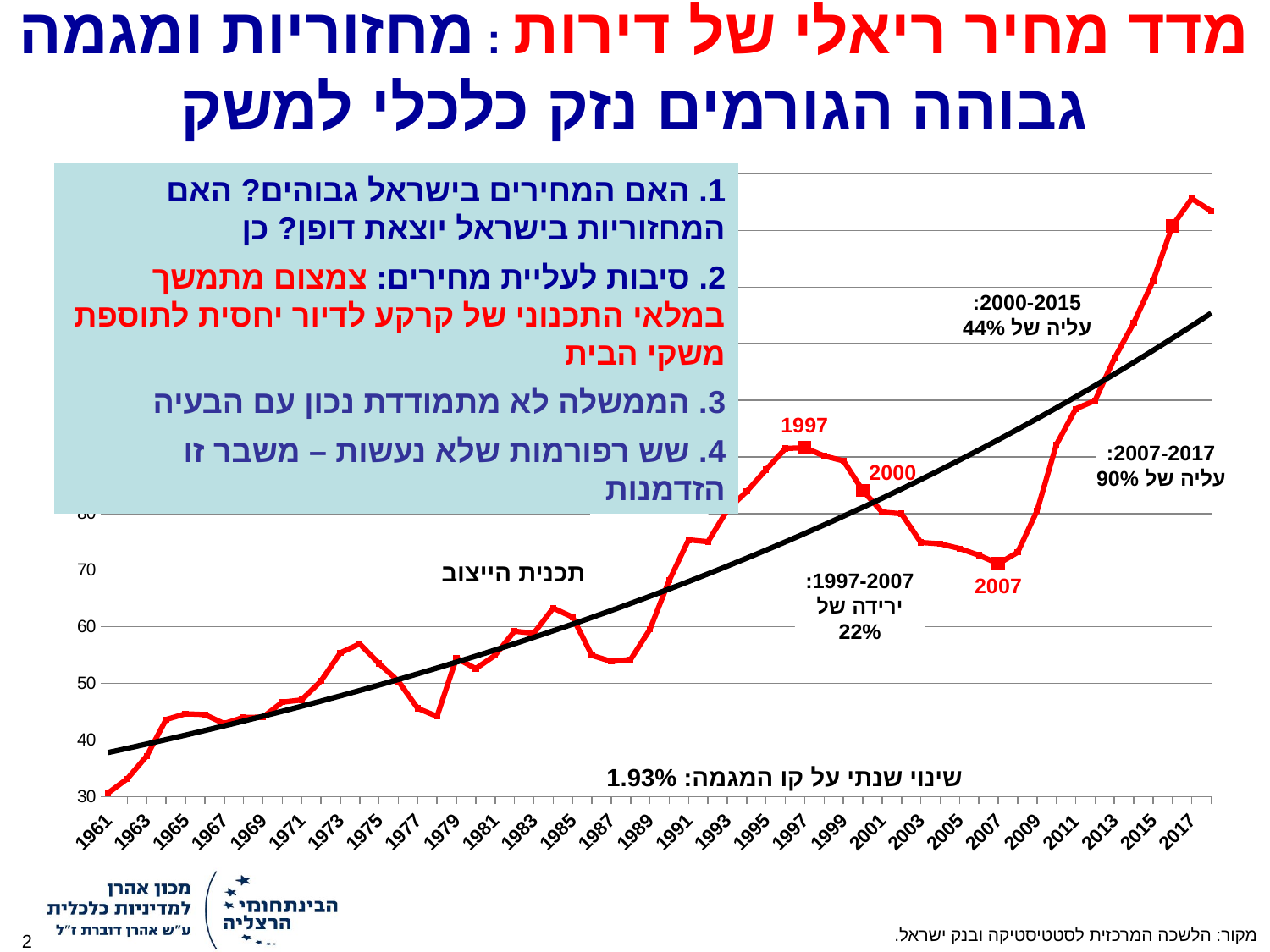
What kind of chart is shown on the slide? line chart Which three years are labelled in red on the chart's line? 1997, 2000, 2007 What annual change on the trend line is stated on the chart? 1.93% Which year has the higher index value, 1997 or 2007? 1997 Is the value of the index in 1997 greater or less than 80? greater According to the annotation on the chart, by what percentage did the index rise between 2000 and 2015? 44% Over the whole period from 1961 to 2017, does the index generally rise or fall? rise According to the annotation on the chart, by what percentage did the index rise between 2007 and 2017? 90% According to the annotation on the chart, by what percentage did the index fall between 1997 and 2007? 22% What is the first year and the last year shown on the x axis? 1961 and 2017 Is the value of the index in 1987 greater or less than 50? greater Is the value of the index in 1961 greater or less than 40? less